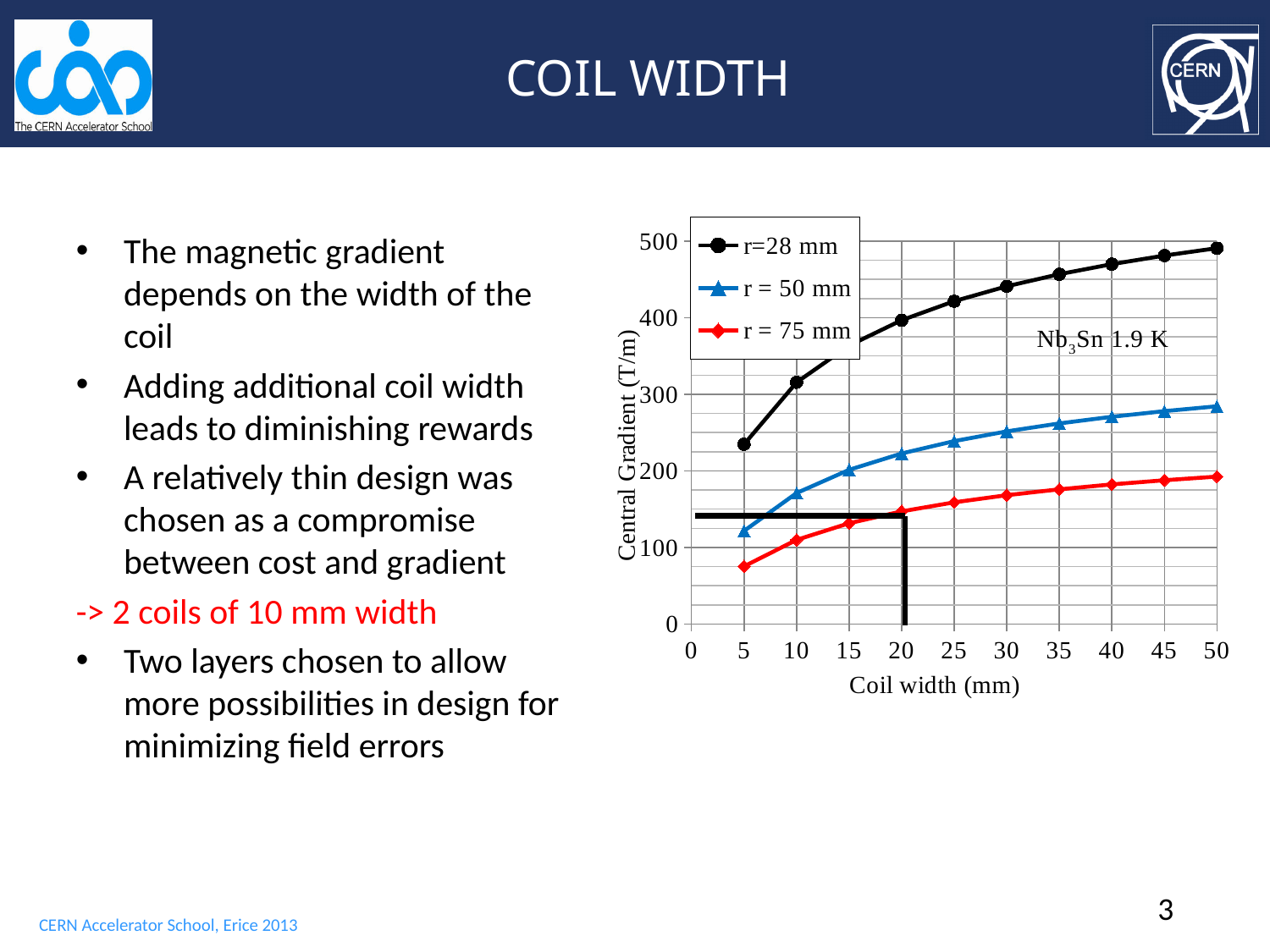
What material and temperature annotation is printed inside the chart? Nb3Sn 1.9 K How many data points are plotted for the r=28 mm series? 10 Is the central gradient for r=28 mm at a coil width of 50 mm greater or less than 400 T/m? greater Which series has the lowest central gradient at a coil width of 5 mm? r = 75 mm Is the central gradient for r = 50 mm at a coil width of 50 mm greater or less than 300 T/m? less Does the central gradient for r=28 mm rise or fall as coil width increases? rise What is the label of the x axis of the chart? Coil width (mm) What kind of chart is shown on the slide? line chart How many series does the legend list? 3 Is the central gradient for r = 75 mm at a coil width of 5 mm greater or less than 100 T/m? less Which series has the highest central gradient at a coil width of 50 mm? r=28 mm At a coil width of 20 mm, which series has the larger central gradient, r=28 mm or r = 75 mm? r=28 mm